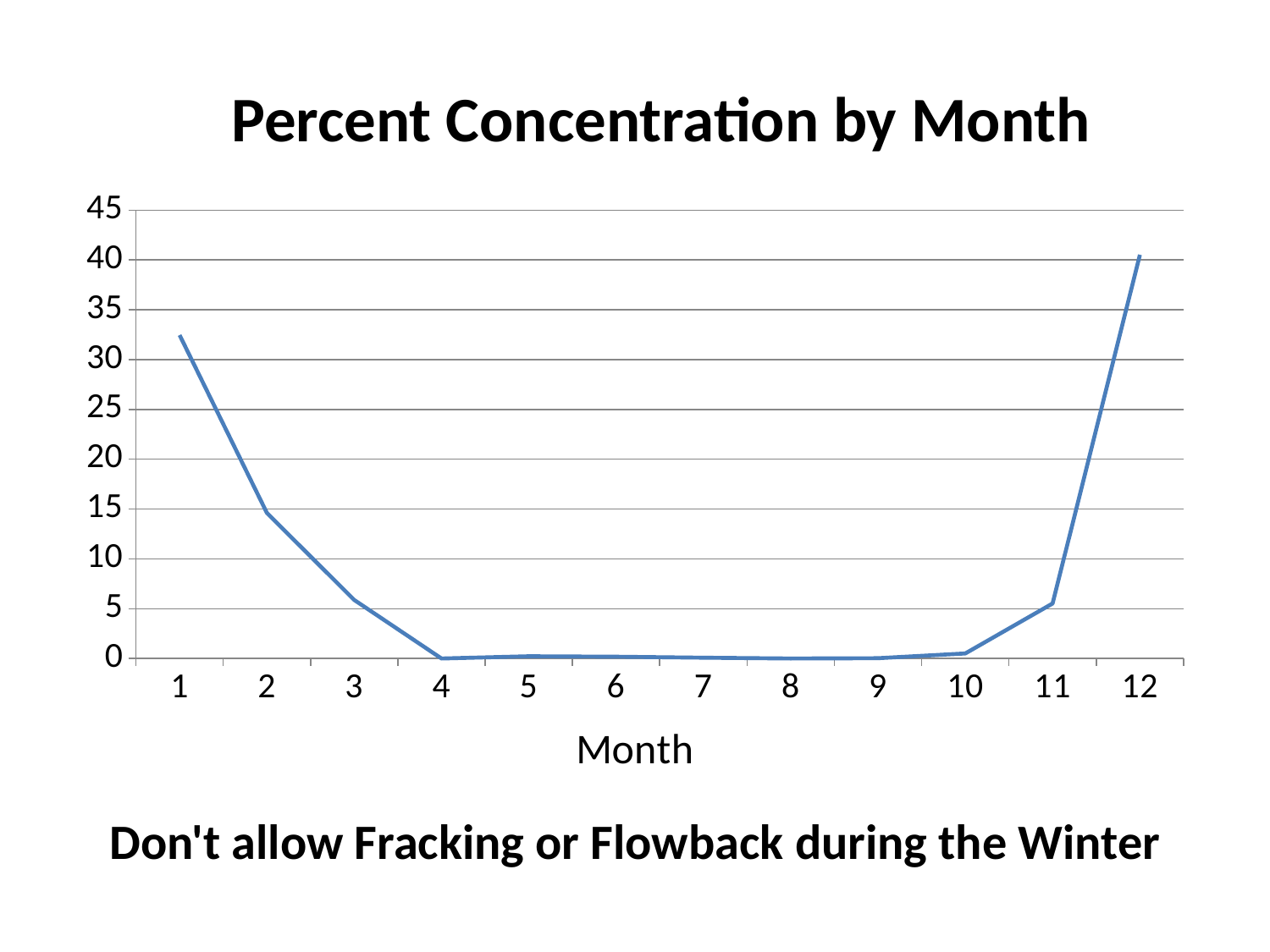
Is the value for month 1 greater or less than 30? greater Is the value for month 8 greater or less than 5? less Is the value for month 3 greater or less than 10? less What is the title of the chart? Percent Concentration by Month Which is larger, the value for month 2 or the value for month 3? month 2 Which is larger, the value for month 1 or the value for month 12? month 12 How many months are plotted on the x axis? 12 Which month has the highest percent concentration? 12 What kind of chart is shown on the slide? line chart Do the values rise or fall from month 1 to month 4? fall What is the label on the x axis of the chart? Month